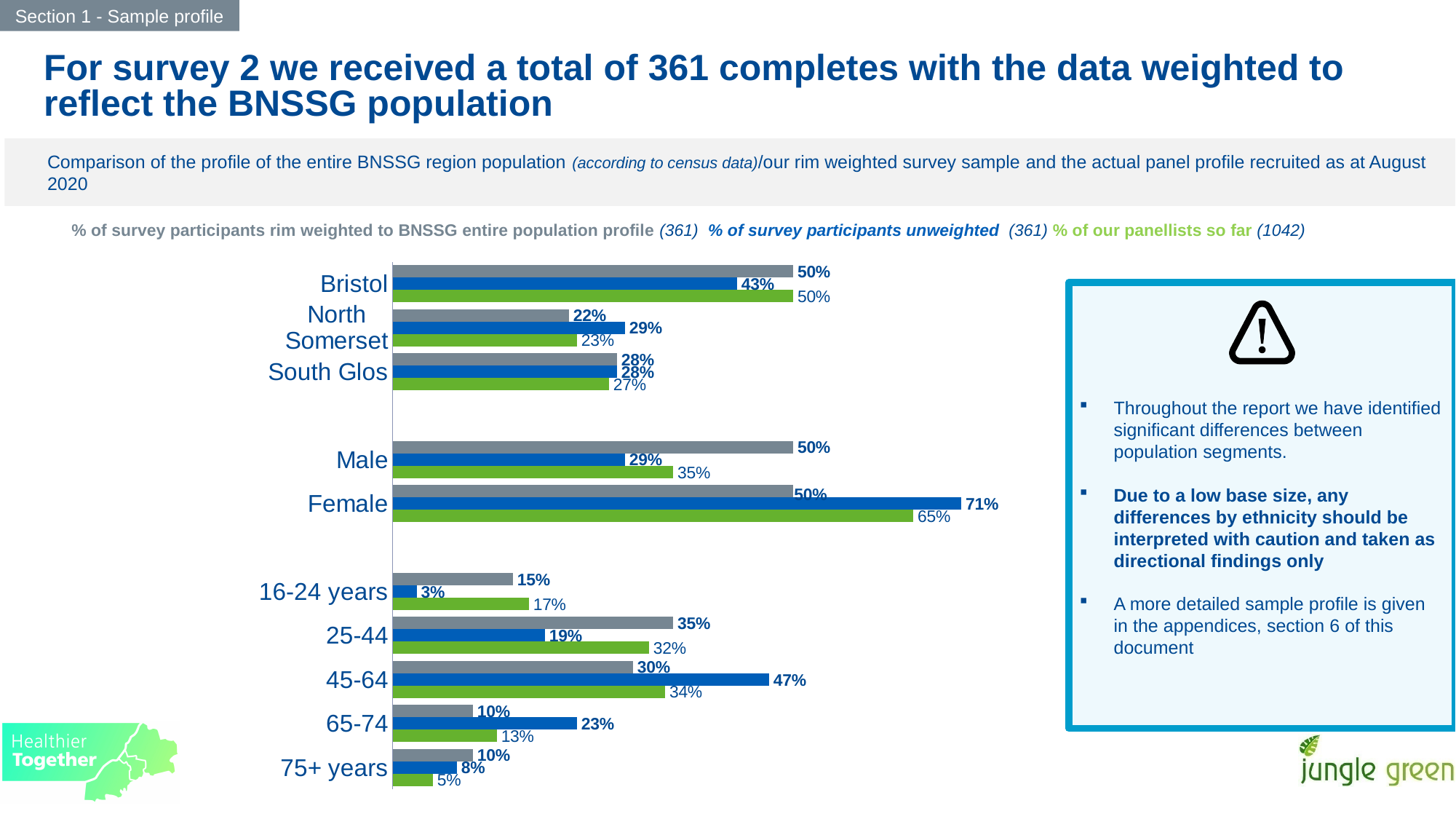
What is the unweighted survey participant percentage for 16-24 years? 3% What type of chart is shown on the slide? Bar chart What is the difference between the unweighted percentage for Female and the unweighted percentage for Male? 42% Which age group has the highest unweighted survey participant percentage? 45-64 What is the base size shown for the panellists so far series? 1042 How many series does the chart legend list? 3 Which age group has the lowest percentage of panellists so far? 75+ years What is the rim weighted percentage for North Somerset? 22% Which is larger for Bristol: the rim weighted percentage or the unweighted percentage? Rim weighted (50%) What percentage of panellists so far are in the 45-64 age group? 34% What is the unweighted survey participant percentage for Female? 71% How many categories are shown on the chart? 10